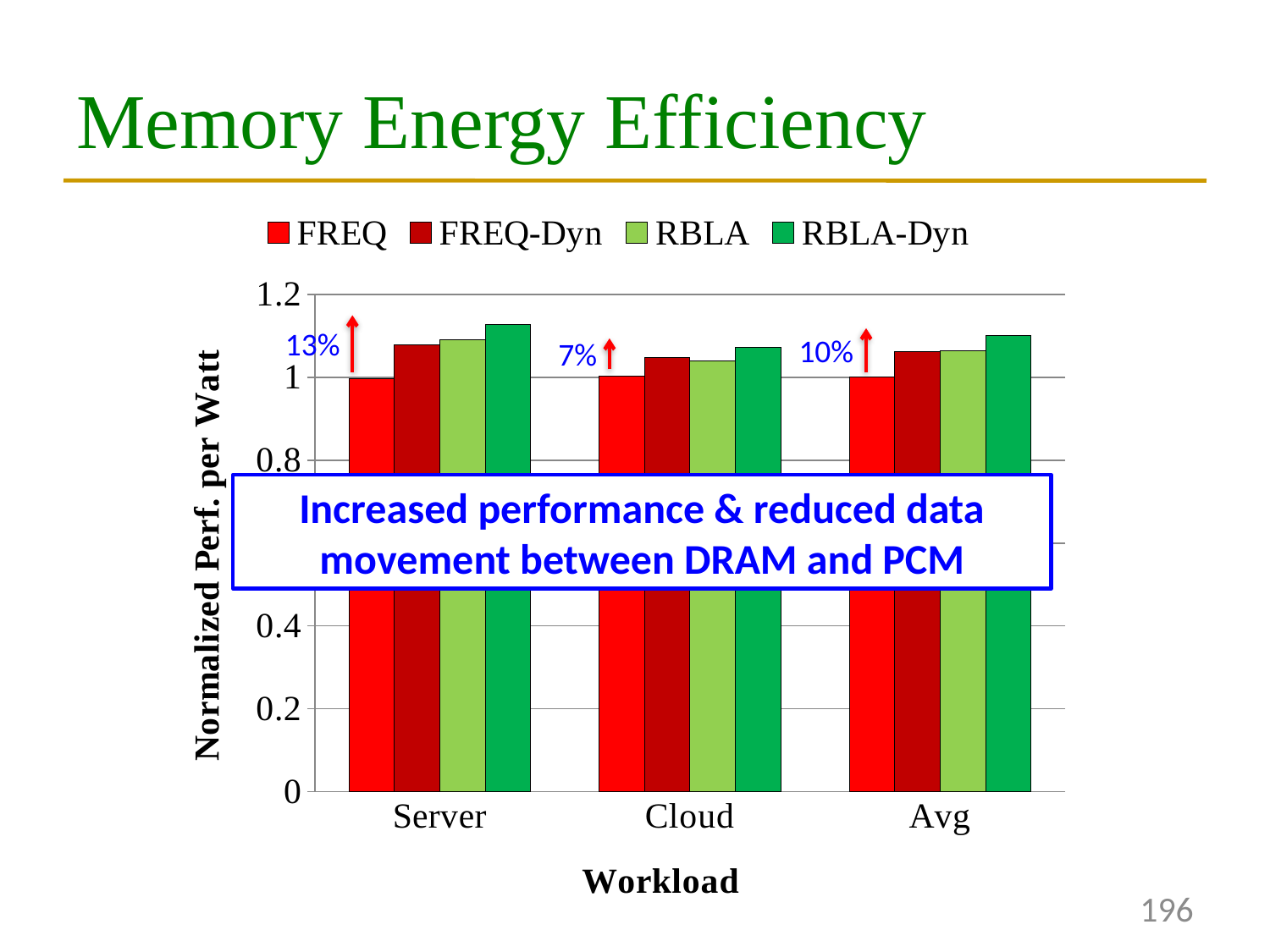
Which is larger: RBLA-Dyn for Server or RBLA-Dyn for Cloud? RBLA-Dyn for Server How many series does the legend list? 4 Which series has the highest value for the Avg workload? RBLA-Dyn What percentage improvement is annotated above the Server workload group? 13% Which series has the lowest value for the Cloud workload? FREQ Is the value of RBLA for the Cloud workload greater or less than 1.2? less How many workload categories are shown on the x axis? 3 Is the value of RBLA-Dyn for the Server workload greater or less than 1? greater Which series has the highest value for the Server workload? RBLA-Dyn What is the value of FREQ for the Avg workload? 1 What kind of chart is shown on the slide? bar chart